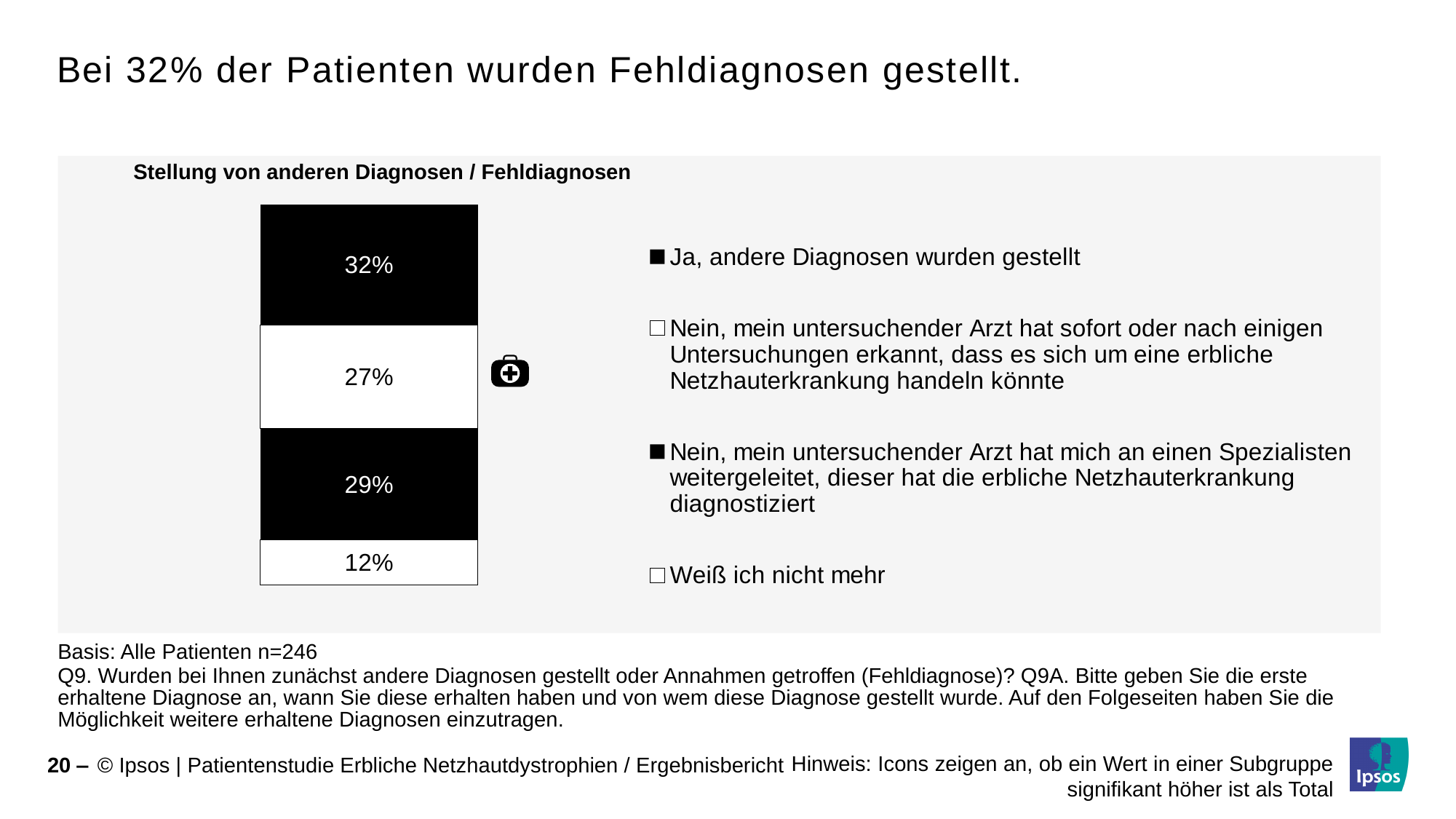
Which legend category has the largest share of the stacked bar? Ja, andere Diagnosen wurden gestellt What is the title of the chart? Stellung von anderen Diagnosen / Fehldiagnosen What is the difference between the "Ja, andere Diagnosen wurden gestellt" segment and the "Weiß ich nicht mehr" segment? 20 percentage points Which legend category has the smallest share of the stacked bar? Weiß ich nicht mehr What is the value for the segment "Nein, mein untersuchender Arzt hat mich an einen Spezialisten weitergeleitet, dieser hat die erbliche Netzhauterkrankung diagnostiziert"? 29% What percentage of patients answered "Weiß ich nicht mehr"? 12% What is the value for the segment "Nein, mein untersuchender Arzt hat sofort oder nach einigen Untersuchungen erkannt, dass es sich um eine erbliche Netzhauterkrankung handeln könnte"? 27% How many entries does the legend list? 4 What kind of chart is shown on the slide? Stacked bar chart Which is larger: the segment for the doctor referring to a specialist (29%) or the segment for the doctor recognising the disease immediately (27%)? The specialist referral segment (29%) How many segments make up the stacked bar? 4 What percentage of patients answered "Ja, andere Diagnosen wurden gestellt"? 32%